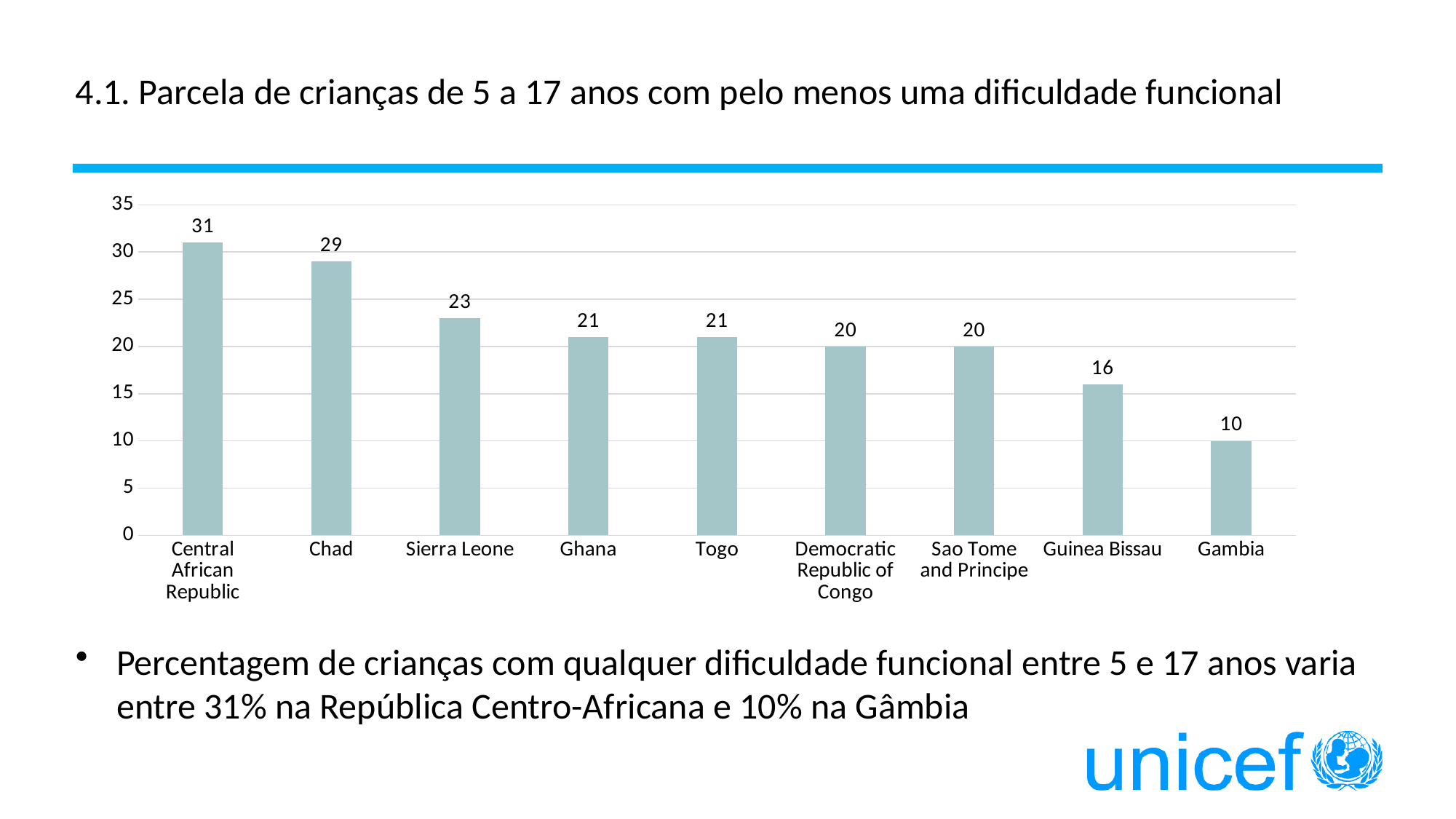
Which country has the lowest value? Gambia What is the difference between the values for Chad and Sierra Leone? 6 What kind of chart is shown on the slide? bar chart What is the value for Sierra Leone? 23 How many countries are shown in the chart? 9 Which country has the highest value? Central African Republic What is the value for Chad? 29 What is the value for Guinea Bissau? 16 What is the difference between the values for Central African Republic and Gambia? 21 Is the value for Sao Tome and Principe greater or less than 25? less Do the values rise or fall from left to right along the x axis? fall Which is larger, the value for Ghana or the value for Guinea Bissau? Ghana